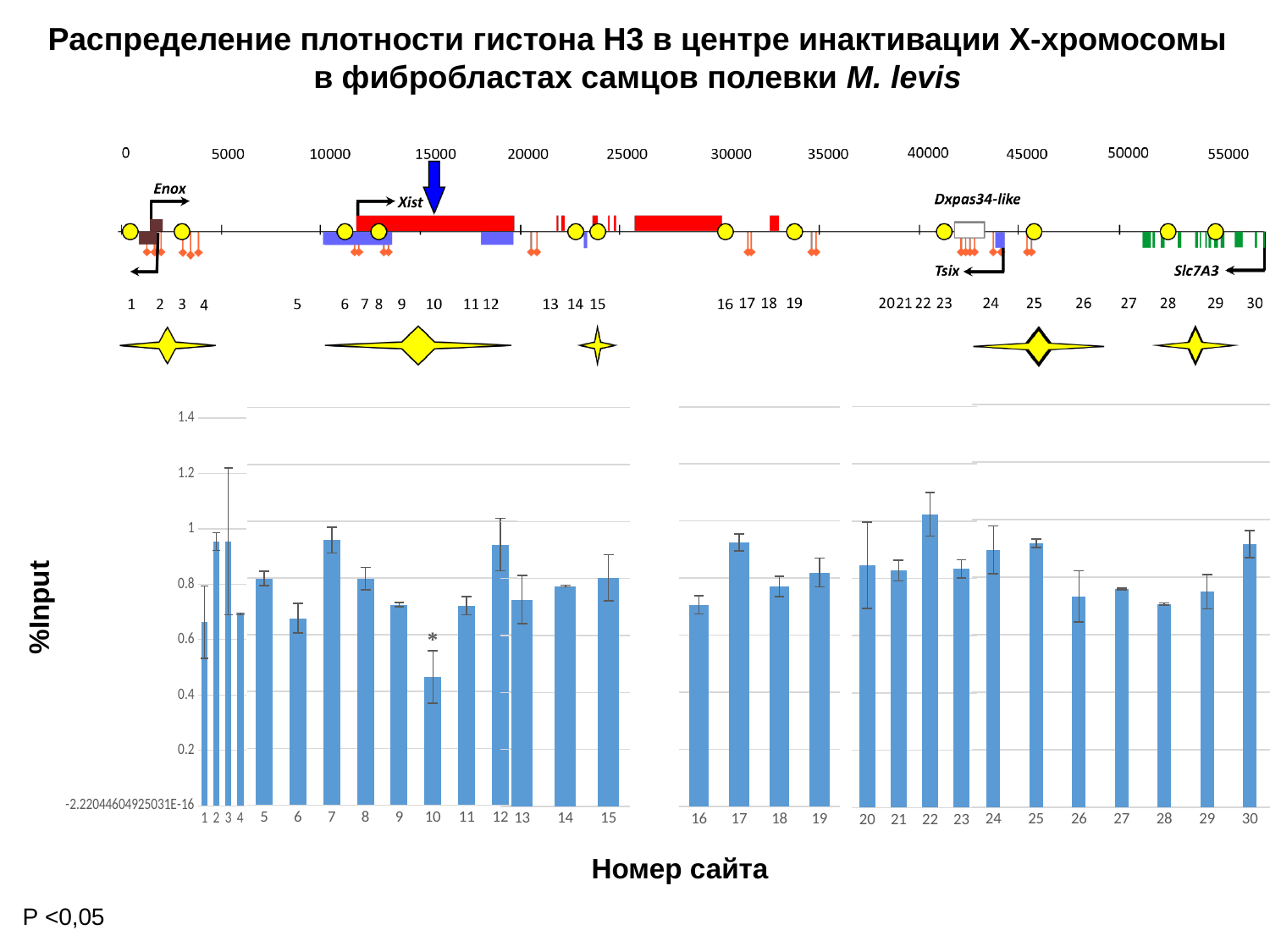
Is the value for site 17 greater or less than 0.8? greater What kind of chart is shown on the slide? bar chart Is the value for site 10 greater or less than 0.6? less How many sites (categories) are plotted on the x axis of the bar chart? 30 Is the value for site 22 greater or less than 1? greater Which site has the highest %Input value in the bar chart? 22 Which has the larger %Input value, site 7 or site 10? site 7 What is the label of the y axis of the bar chart? %Input Which site has the lowest %Input value in the bar chart? 10 Which has the larger %Input value, site 12 or site 13? site 12 Which site's bar is marked with an asterisk in the chart? 10